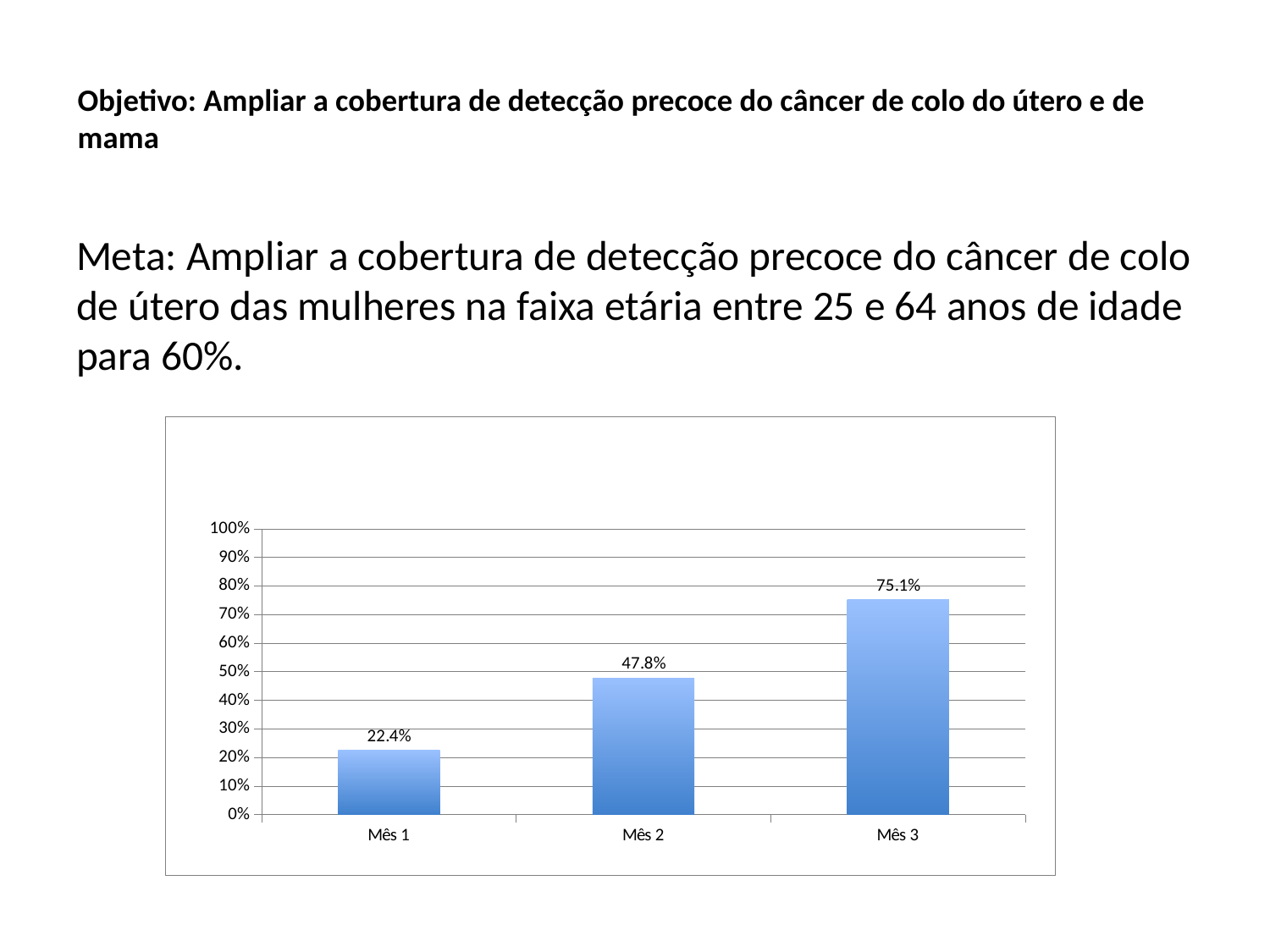
What kind of chart is shown on the slide? bar chart What is the value for Mês 2? 47.8% Which category has the highest value? Mês 3 How many categories are shown on the x axis? 3 What is the value for Mês 1? 22.4% What is the value for Mês 3? 75.1% Do the values rise or fall from Mês 1 to Mês 3? rise Is the value for Mês 3 greater or less than 60%? greater Which is larger, the value for Mês 1 or the value for Mês 2? Mês 2 What is the difference between the values for Mês 2 and Mês 1? 25.4% What is the difference between the values for Mês 3 and Mês 2? 27.3% Which category has the lowest value? Mês 1